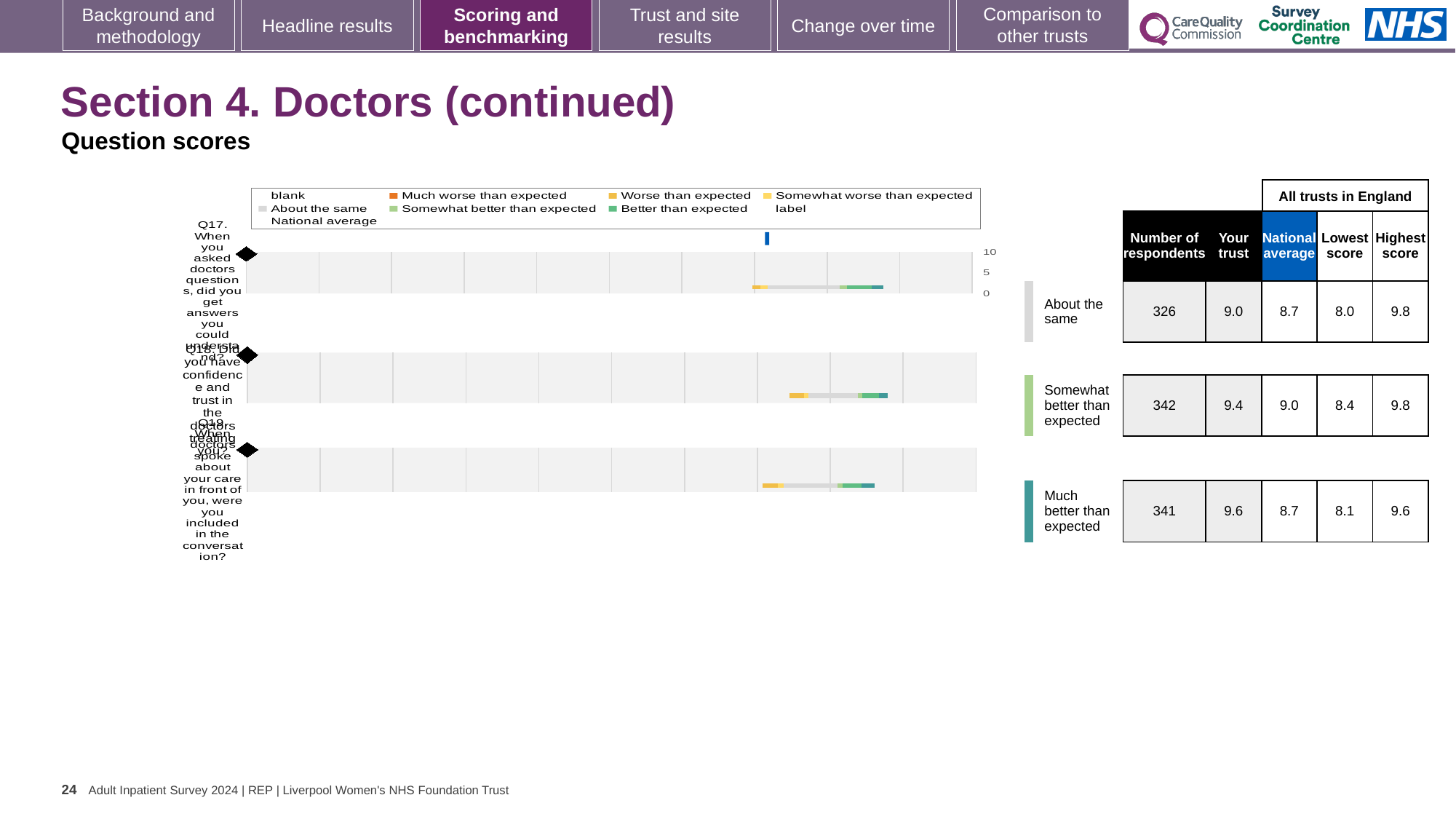
For Q18, which is larger: the 'Your trust' score or the national average? Your trust What is the 'Your trust' score for Q18 (confidence and trust in doctors)? 9.4 What is the difference between the 'Your trust' scores for Q19 and Q17? 0.6 What kind of chart is shown on the slide? bar chart What is the 'Your trust' score for Q19 (included in the conversation)? 9.6 Which question has the lowest 'Your trust' score? Q17 Which question has the highest 'Your trust' score? Q19 How many questions (rows) are plotted in the chart? 3 Which benchmark category is Q19 placed in? Much better than expected What is the highest score across all trusts in England for Q18? 9.8 How many respondents answered Q18? 342 What is the 'Your trust' score for Q17 (answers you could understand)? 9.0